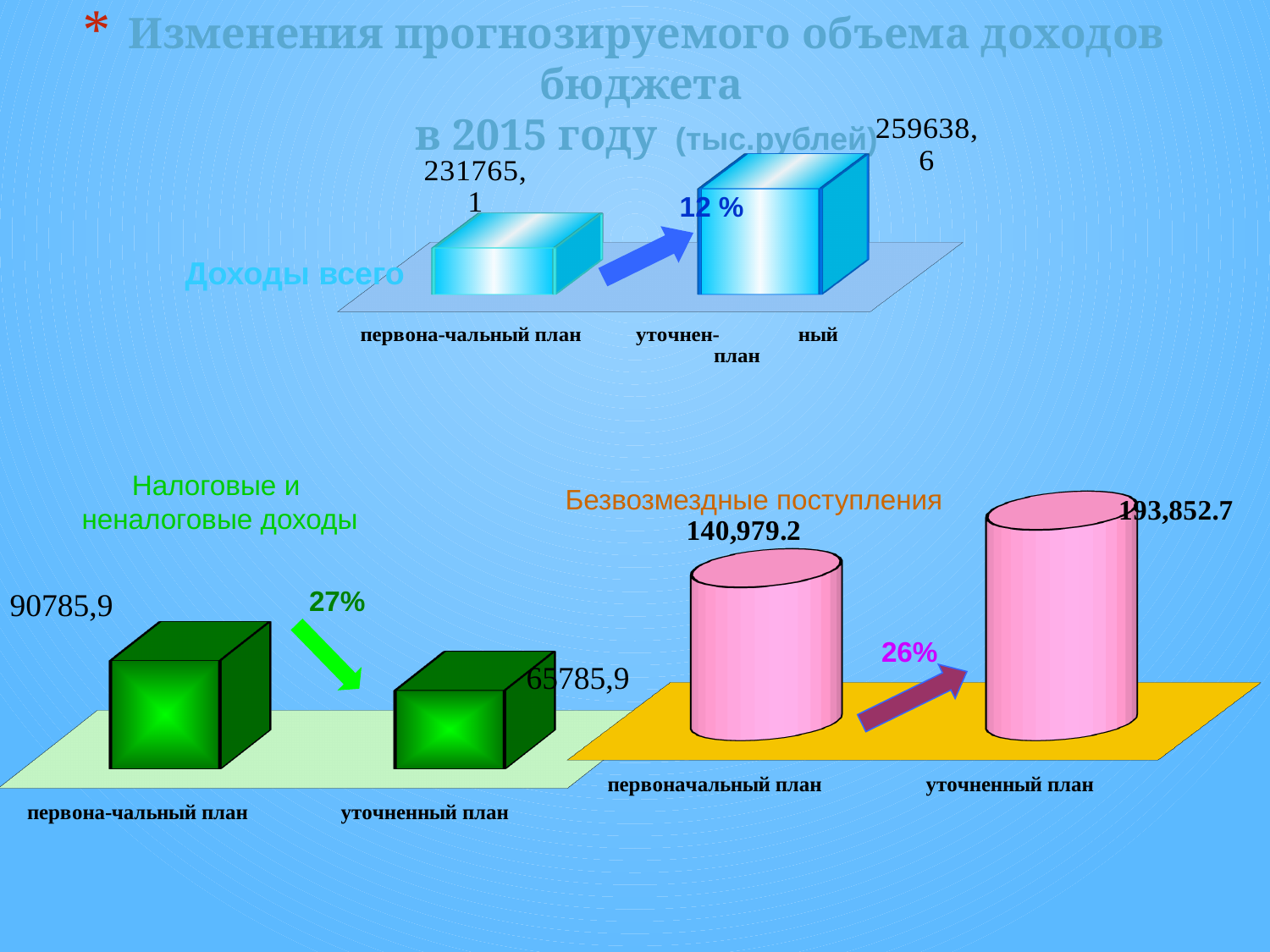
In the 'Доходы всего' chart, what is the value for уточненный план? 259638,6 In the 'Налоговые и неналоговые доходы' chart, what is the value for первоначальный план? 90785,9 In the 'Доходы всего' chart, what is the difference between уточненный план and первоначальный план? 27873,5 In the 'Безвозмездные поступления' chart, what is the value for первоначальный план? 140,979.2 In the 'Безвозмездные поступления' chart, what is the value for уточненный план? 193,852.7 How many categories does the 'Безвозмездные поступления' chart show? 2 In the 'Налоговые и неналоговые доходы' chart, do the values rise or fall from первоначальный план to уточненный план? fall In the 'Безвозмездные поступления' chart, which plan has the higher value? уточненный план In the 'Доходы всего' chart, what is the value for первоначальный план? 231765,1 In the 'Налоговые и неналоговые доходы' chart, what is the value for уточненный план? 65785,9 In the 'Доходы всего' chart, what percentage change is shown between the two plans? 12 % In the 'Налоговые и неналоговые доходы' chart, what is the difference between первоначальный план and уточненный план? 25000